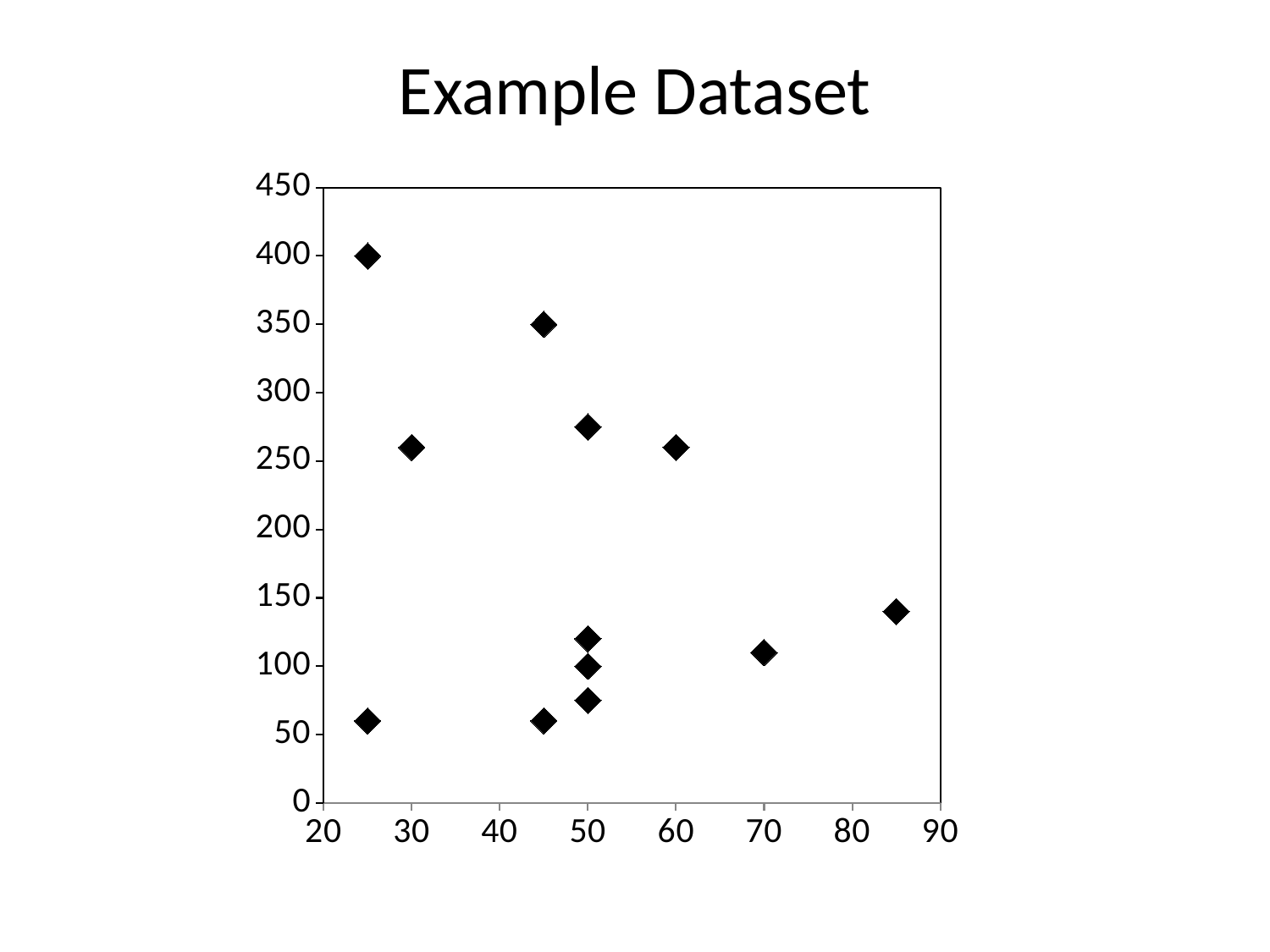
Is the y value of the point at x = 30 greater or less than 200? greater How many data points are plotted on the chart? 12 What is the title of the chart? Example Dataset Which has the larger y value: the point at x = 60 or the point at x = 70? the point at x = 60 Is the y value of the point at x = 70 greater or less than 150? less Is the y value of the point at x = 60 greater or less than 300? less What kind of chart is shown on the slide? scatter chart How many data points have a y value above 300? 2 How many data points are plotted at x = 50? 4